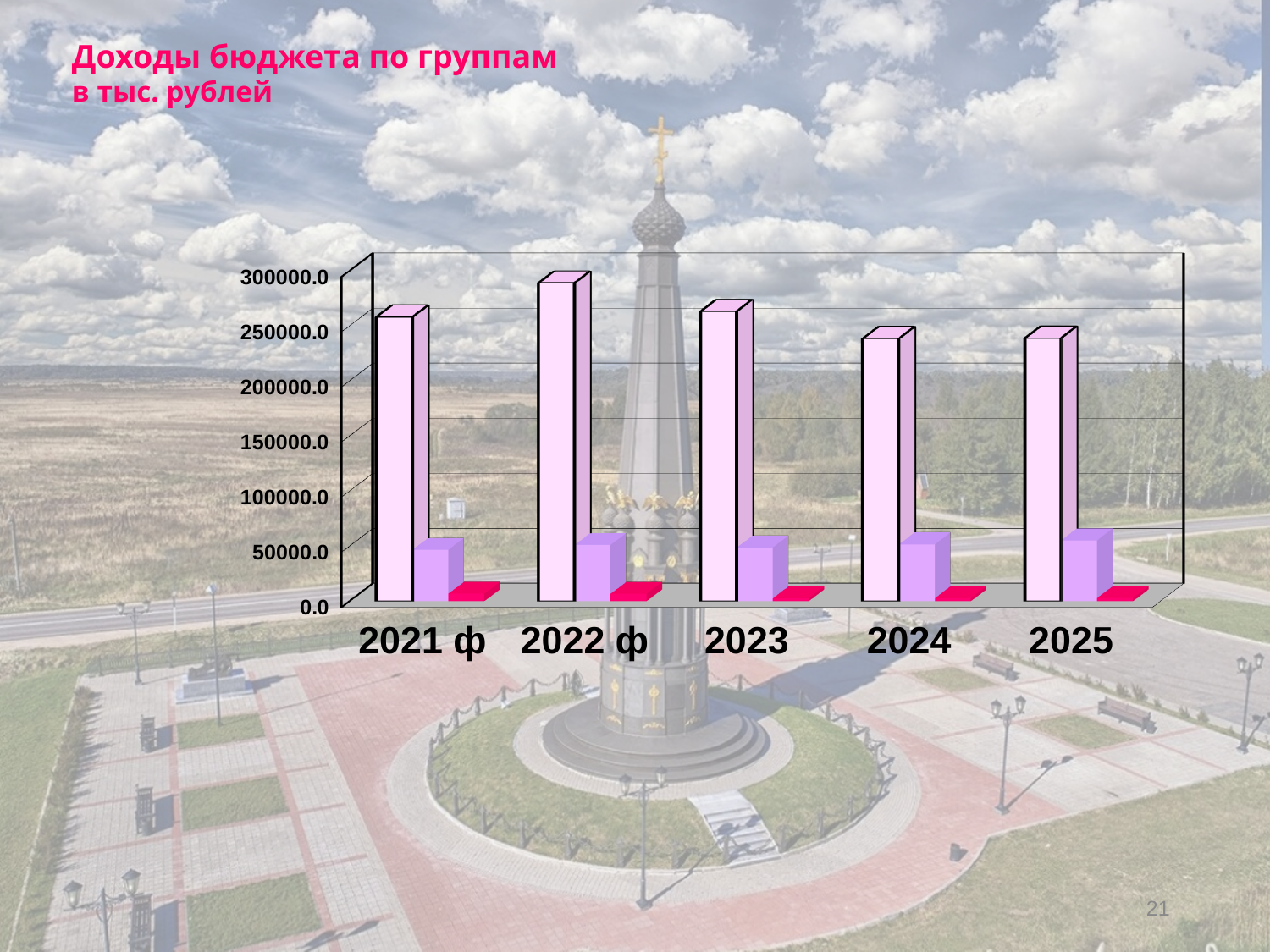
Is the lavender (middle) bar for 2023 greater or less than 100000.0? less Which light pink bar is taller, 2022 ф or 2023? 2022 ф Is the light pink bar for 2022 ф greater or less than 250000.0? greater Is the magenta (smallest) bar for 2025 greater or less than 50000.0? less Which category has the tallest light pink bar? 2022 ф In what units are the values on the chart expressed, according to the subtitle? тыс. рублей How many categories are shown on the x axis of the chart? 5 Do the light pink bars rise or fall from 2022 ф to 2025? fall What kind of chart is shown on the slide? bar chart Which light pink bar is taller, 2021 ф or 2024? 2021 ф What is the title of the chart on the slide? Доходы бюджета по группам